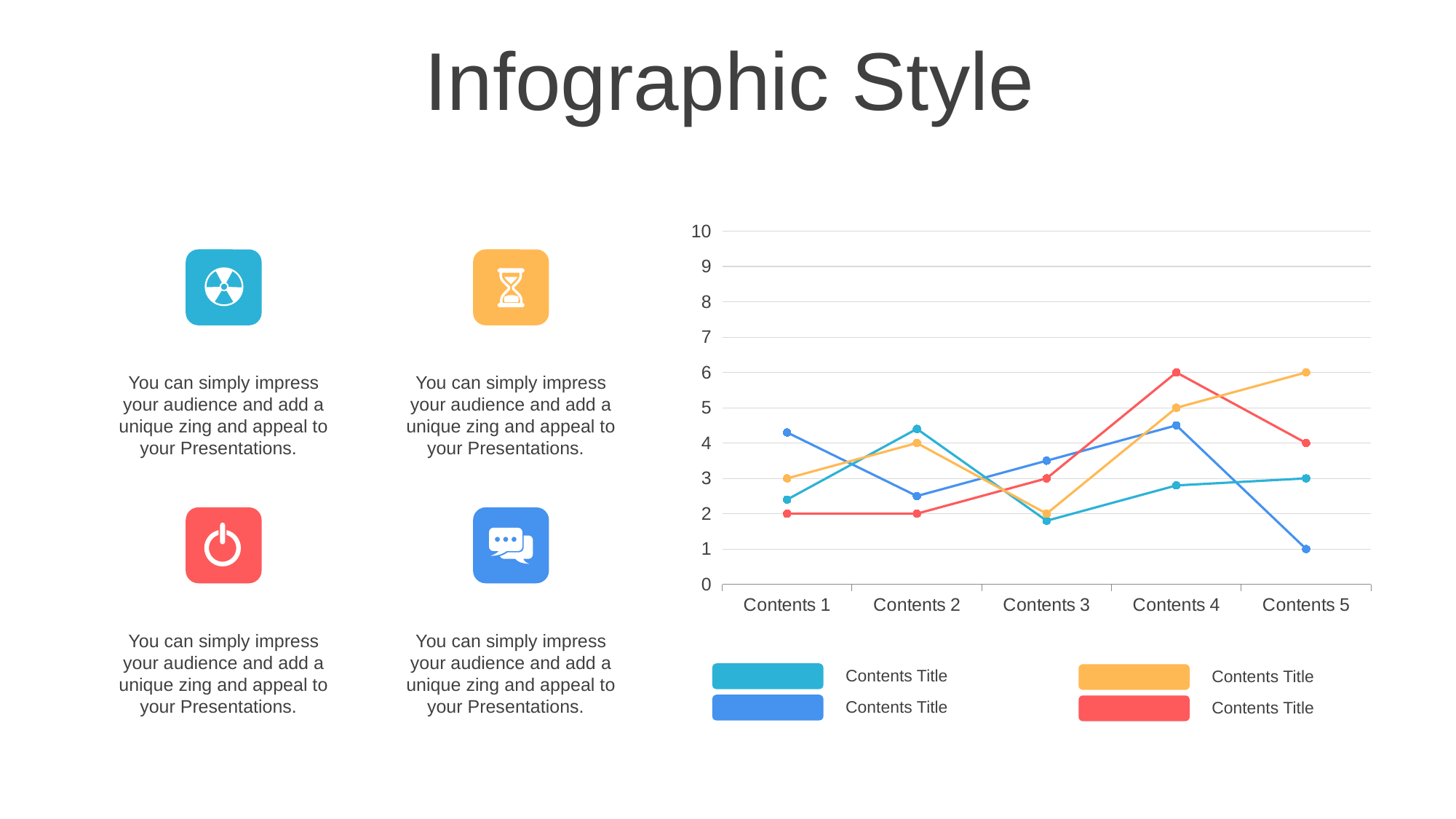
How many categories are shown on the x axis of the chart? 5 What is the value of the red line at Contents 4? 6 What is the difference between the yellow line's value at Contents 5 and its value at Contents 1? 3 Is the value of the teal line at Contents 2 greater or less than 4? greater At Contents 4, which line has the larger value, the red line or the yellow line? red line At which category does the yellow line reach its highest value? Contents 5 At which category does the blue line reach its lowest value? Contents 5 Does the red line rise or fall from Contents 4 to Contents 5? fall What is the value of the yellow line at Contents 5? 6 What is the value of the blue line at Contents 5? 1 What kind of chart is shown on the slide? line chart How many series does the chart's legend list? 4